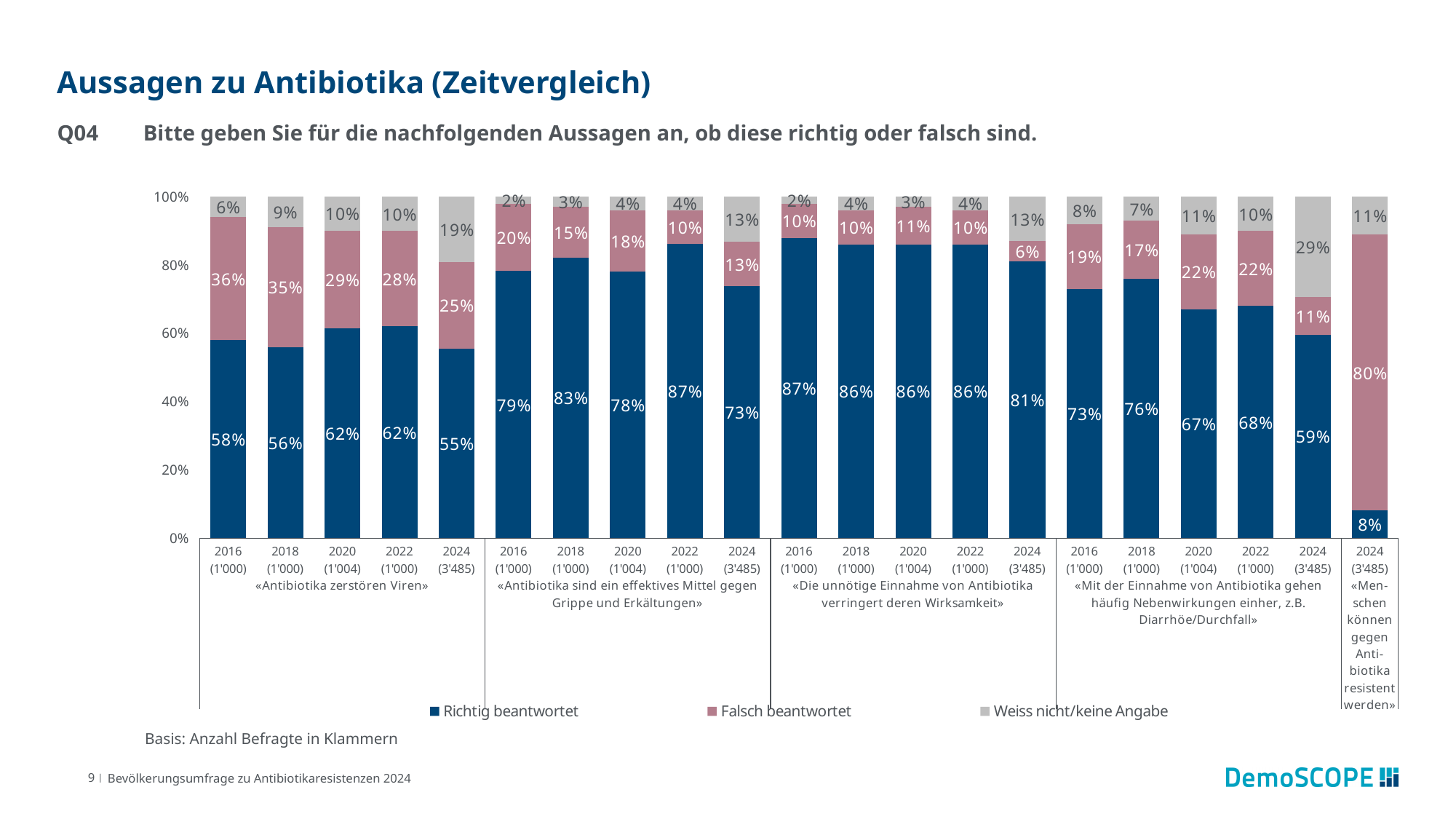
What kind of chart is shown on the slide? Stacked bar chart What share answered «Weiss nicht/keine Angabe» in 2024 for the statement «Mit der Einnahme von Antibiotika gehen häufig Nebenwirkungen einher, z.B. Diarrhöe/Durchfall»? 29% Which year has the highest share of correct answers for the statement «Antibiotika sind ein effektives Mittel gegen Grippe und Erkältungen»? 2022 What share answered incorrectly («Falsch beantwortet») in 2024 for the statement «Menschen können gegen Antibiotika resistent werden»? 80% How did the share of «Weiss nicht/keine Angabe» for «Antibiotika zerstören Viren» change from 2016 to 2024? It rose (from 6% to 19%) Which year has the lowest share of correct answers for the statement «Mit der Einnahme von Antibiotika gehen häufig Nebenwirkungen einher, z.B. Diarrhöe/Durchfall»? 2024 What share answered correctly («Richtig beantwortet») in 2024 for the statement «Antibiotika zerstören Viren»? 55% How many series does the legend list? 3 How many bars are shown for the statement «Menschen können gegen Antibiotika resistent werden»? 1 For the statement «Antibiotika zerstören Viren», which year has the larger share of incorrect answers, 2016 or 2024? 2016 Which colour represents «Richtig beantwortet» in the chart? Dark blue By how many percentage points did the share of correct answers for «Die unnötige Einnahme von Antibiotika verringert deren Wirksamkeit» fall from 2016 to 2024? 6